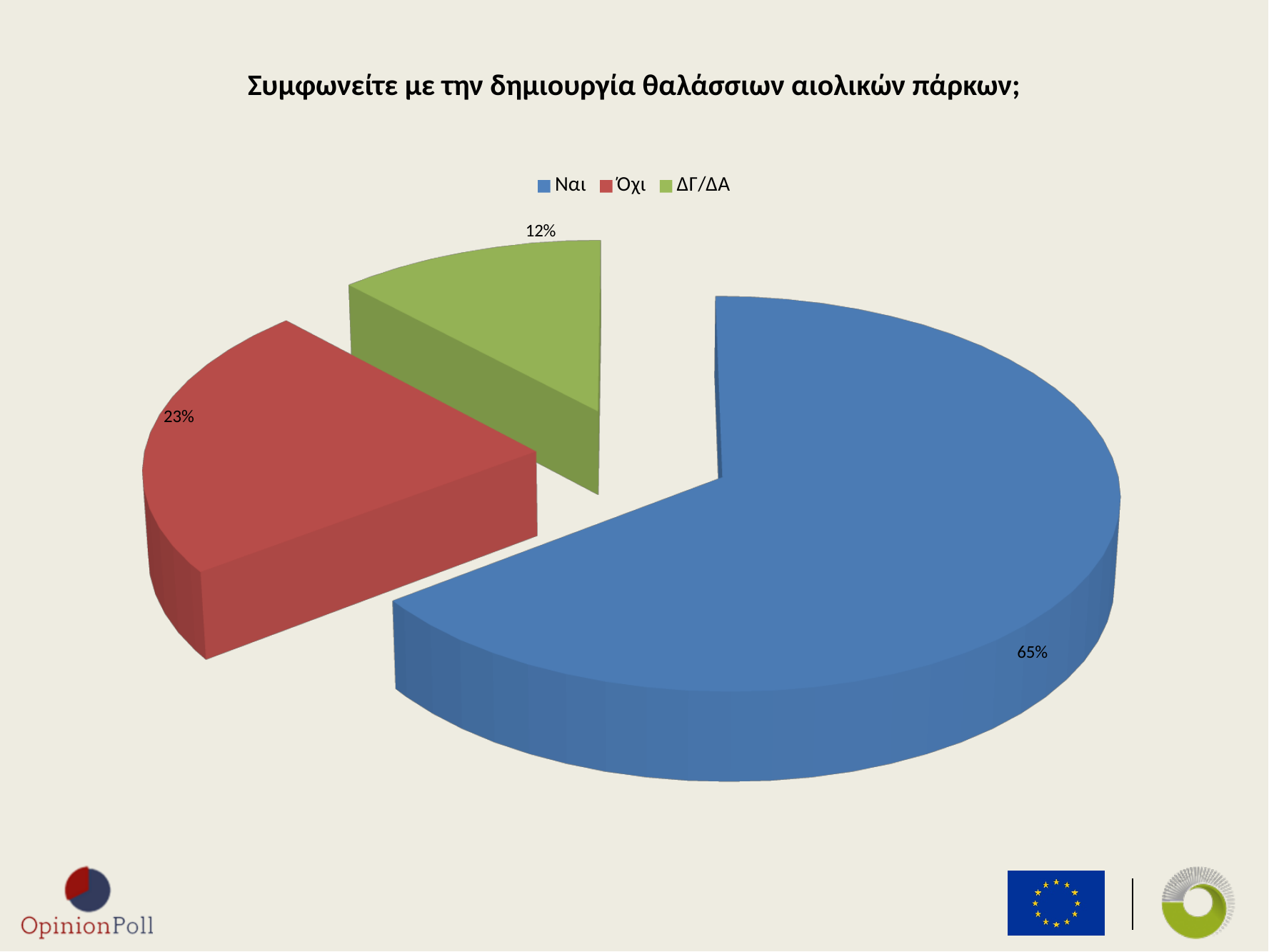
What is the difference in percentage points between Ναι and Όχι? 42 What percentage of respondents answered Ναι? 65% What kind of chart is shown on the slide? Pie chart Which response has the largest share of the pie? Ναι How many entries does the legend list? 3 Which is larger, the share for Όχι or the share for ΔΓ/ΔΑ? Όχι What is the difference in percentage points between Όχι and ΔΓ/ΔΑ? 11 What colour is the slice for Όχι? Red What percentage of respondents answered ΔΓ/ΔΑ? 12% How many slices does the pie chart have? 3 Which response has the smallest share of the pie? ΔΓ/ΔΑ What percentage of respondents answered Όχι? 23%